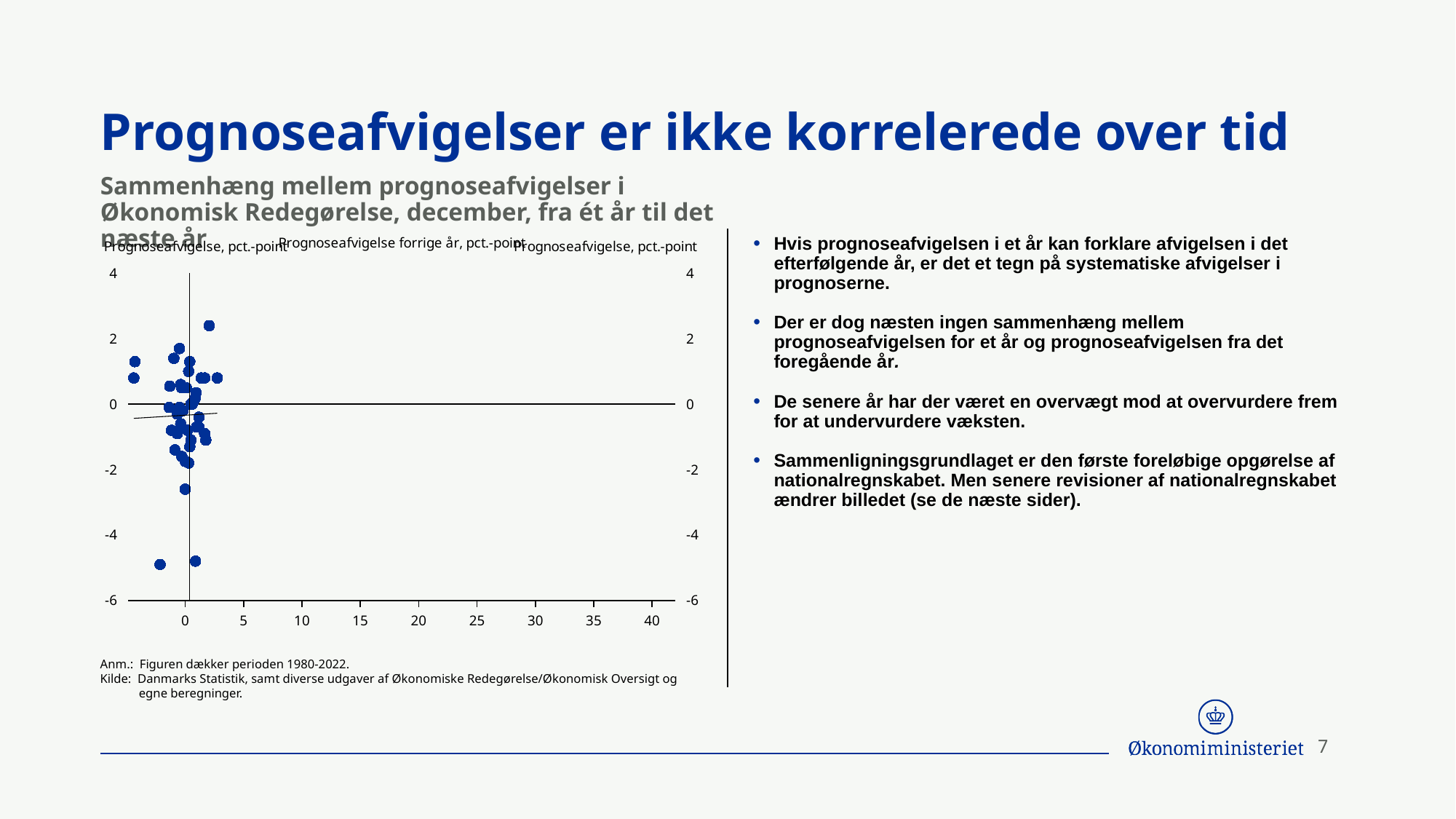
Is the largest value on the horizontal axis among the plotted points greater or less than 5? less Is the lowest point on the vertical axis greater or less than -6? greater Is the lowest point on the vertical axis greater or less than -4? less What kind of chart is shown on the slide? scatter chart What is the label of the horizontal axis of the chart? Prognoseafvigelse forrige år, pct.-point What is the title of the chart on the slide? Sammenhæng mellem prognoseafvigelser i Økonomisk Redegørelse, december, fra ét år til det næste år